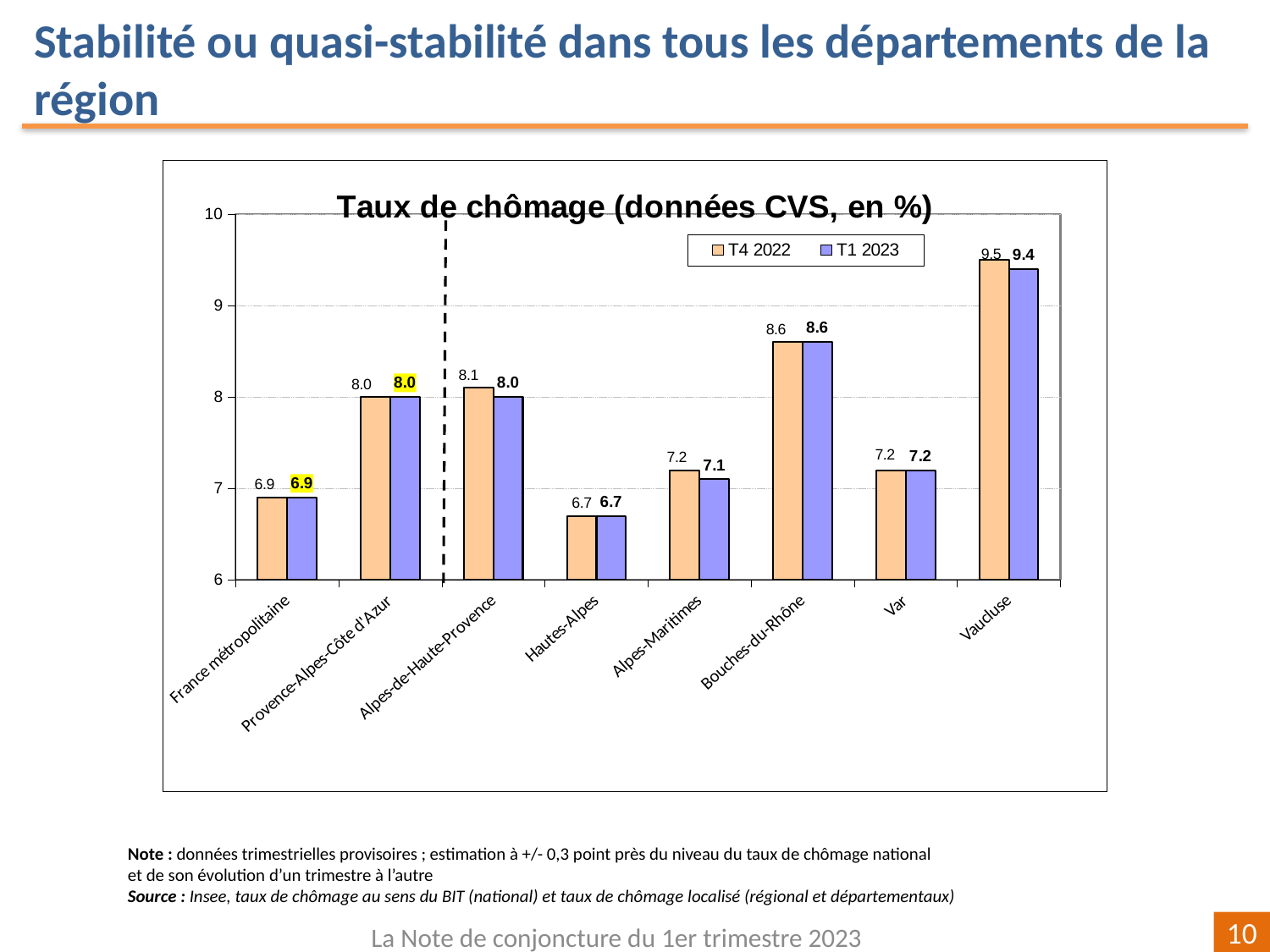
Which category has the highest T1 2023 unemployment rate? Vaucluse Which category has the lowest T4 2022 unemployment rate? Hautes-Alpes What is the difference between the T1 2023 values for Bouches-du-Rhône and Hautes-Alpes? 1.9 How many categories are shown on the x axis? 8 What is the difference between the T4 2022 and T1 2023 values for Vaucluse? 0.1 What is the T1 2023 value for Bouches-du-Rhône? 8.6 What is the title of the chart? Taux de chômage (données CVS, en %) How many series does the legend list? 2 What is the T4 2022 unemployment rate for Alpes-de-Haute-Provence? 8.1 Which is larger in T1 2023: Alpes-Maritimes or Var? Var What is the T1 2023 unemployment rate for Vaucluse? 9.4 What kind of chart is shown? Bar chart